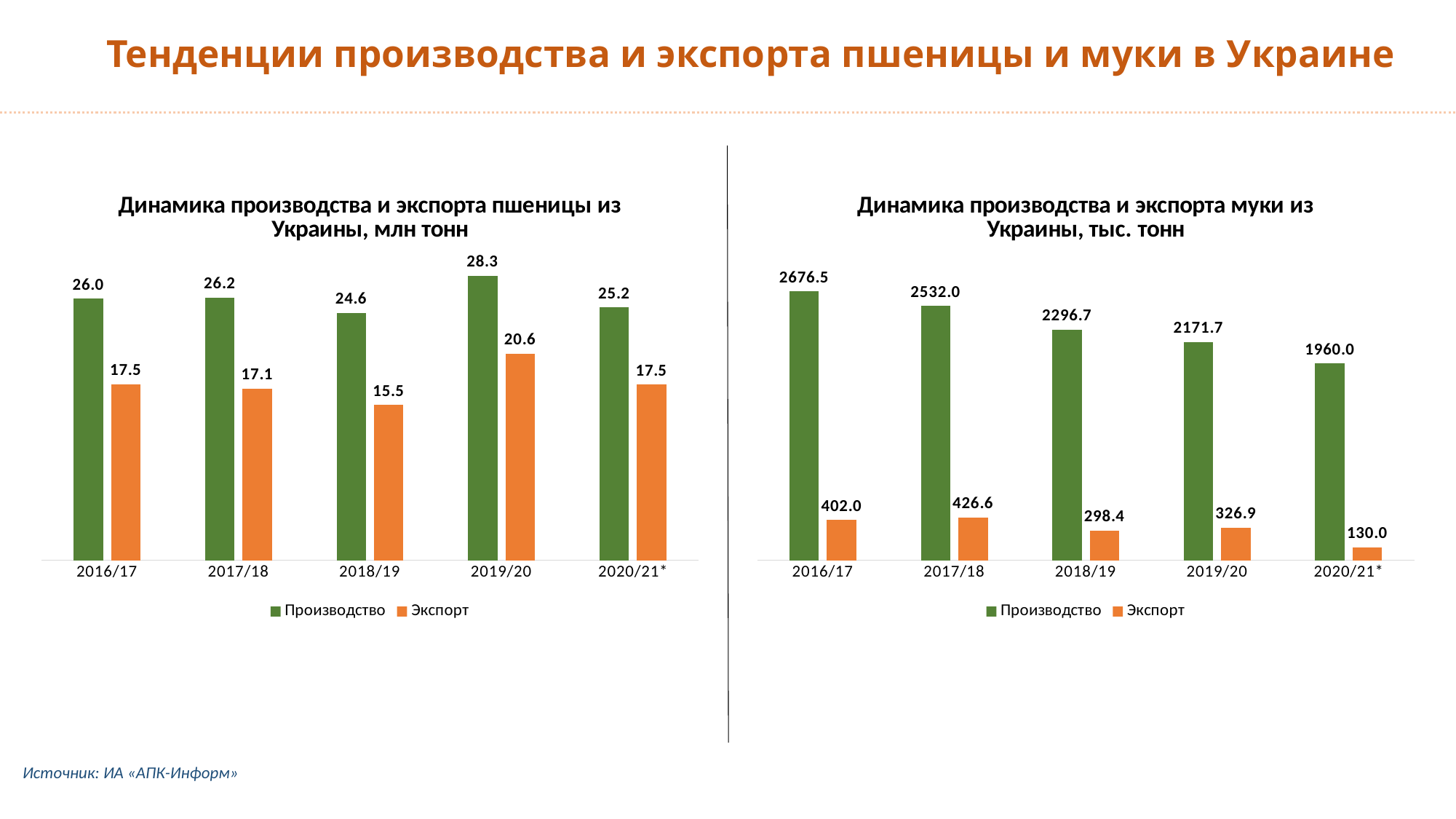
In the right chart (flour, тыс. тонн), does Производство rise or fall from 2016/17 to 2020/21*? fall In the right chart (flour, тыс. тонн), what is the Экспорт value for 2020/21*? 130.0 In the left chart (wheat, млн тонн), which season has the highest Экспорт value? 2019/20 How many seasons are shown on the x axis of the left chart (wheat, млн тонн)? 5 In the left chart (wheat, млн тонн), which season has the lowest Производство value? 2018/19 In the right chart (flour, тыс. тонн), which season has the highest Экспорт value? 2017/18 In the right chart (flour, тыс. тонн), what is the Производство value for 2017/18? 2532.0 In the left chart (wheat, млн тонн), what is the Экспорт value for 2018/19? 15.5 In the left chart (wheat, млн тонн), what is the difference between Производство and Экспорт in 2020/21*? 7.7 In the right chart (flour, тыс. тонн), which is larger: Экспорт in 2018/19 or Экспорт in 2019/20? 2019/20 How many series does the legend of the right chart (flour, тыс. тонн) list? 2 In the left chart (wheat, млн тонн), what is the Производство value for 2019/20? 28.3